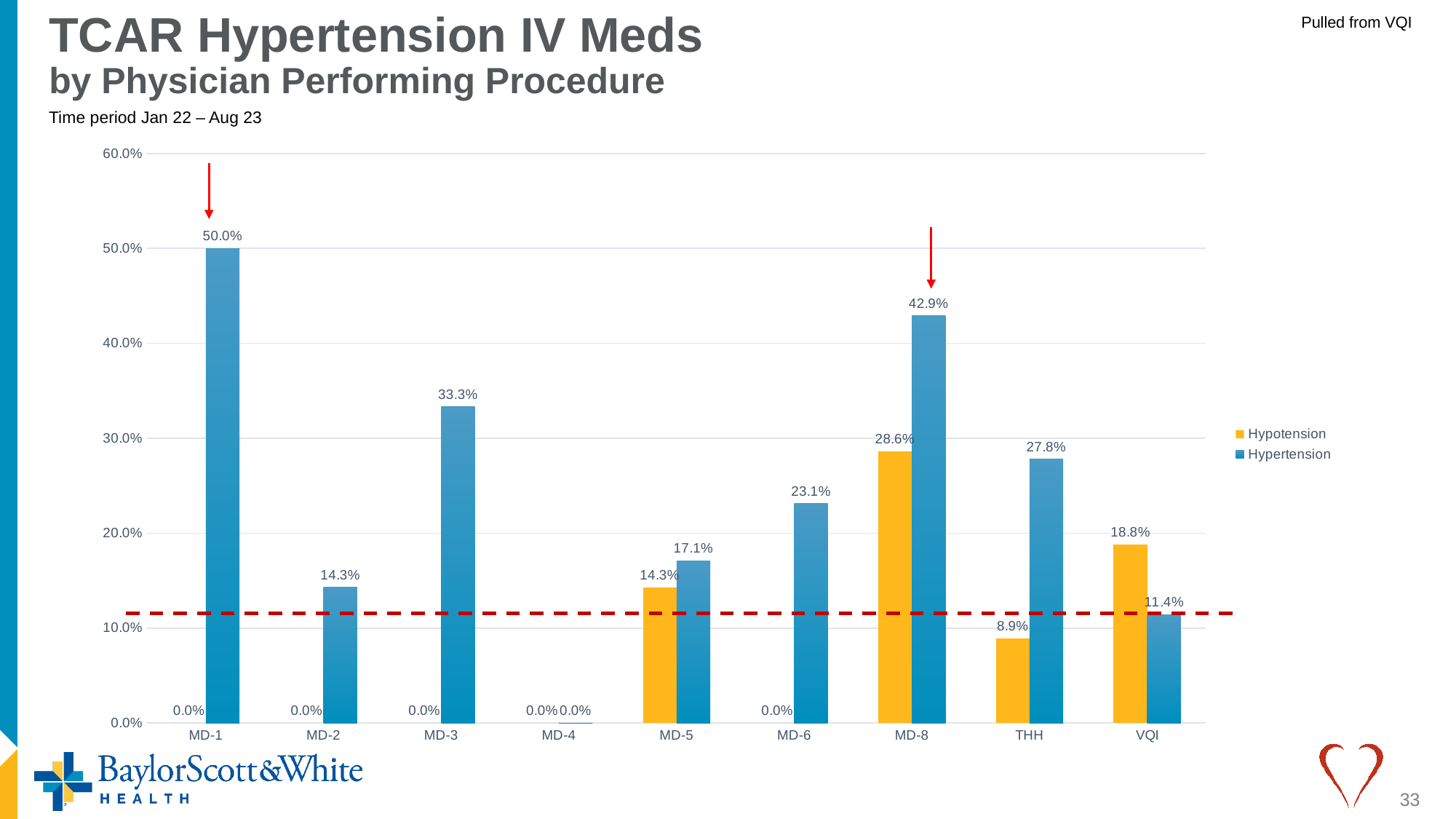
Which category has the highest Hypertension value? MD-1 Which category has the highest Hypotension value? MD-8 Which is larger for VQI, the Hypotension value or the Hypertension value? Hypotension What is the difference between the Hypertension values for MD-8 and MD-3? 9.6% How many categories are shown on the x axis? 9 What is the Hypertension value for THH? 27.8% What is the Hypertension value for MD-1? 50.0% What kind of chart is shown on the slide? Bar chart How many series does the legend list? 2 What time period does the chart cover? Jan 22 – Aug 23 What is the Hypotension value for MD-8? 28.6% What is the Hypotension value for VQI? 18.8%